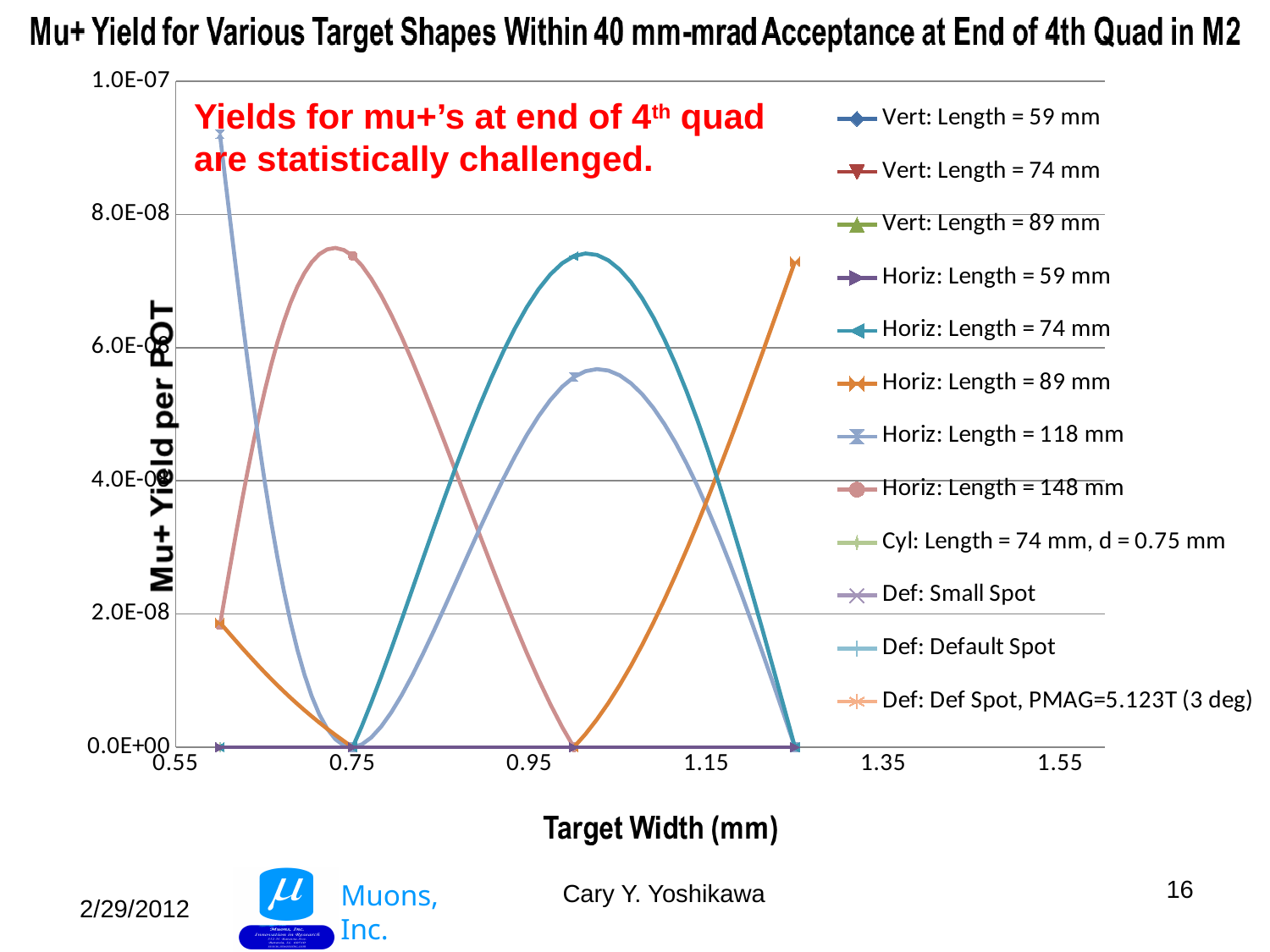
Is the value of the Horiz: Length = 118 mm series at its leftmost point greater or less than 8.0E-08? greater Does the Horiz: Length = 89 mm series rise or fall between target widths of 1.0 mm and 1.25 mm? Rise How many series does the legend list? 12 What kind of chart is shown on the slide? Line chart Is the peak value of the Horiz: Length = 118 mm series near a target width of 1.0 mm greater or less than 6.0E-08? less What is the title of the x axis? Target Width (mm) What is the title of the y axis? Mu+ Yield per POT Which series reaches the highest value anywhere on the chart? Horiz: Length = 118 mm Is the peak value of the Horiz: Length = 148 mm series greater or less than 6.0E-08? greater At a target width of about 1.0 mm, which series has the larger value: Horiz: Length = 74 mm or Horiz: Length = 118 mm? Horiz: Length = 74 mm Does the Horiz: Length = 118 mm series rise or fall between its first point and the point at 0.75 mm? Fall